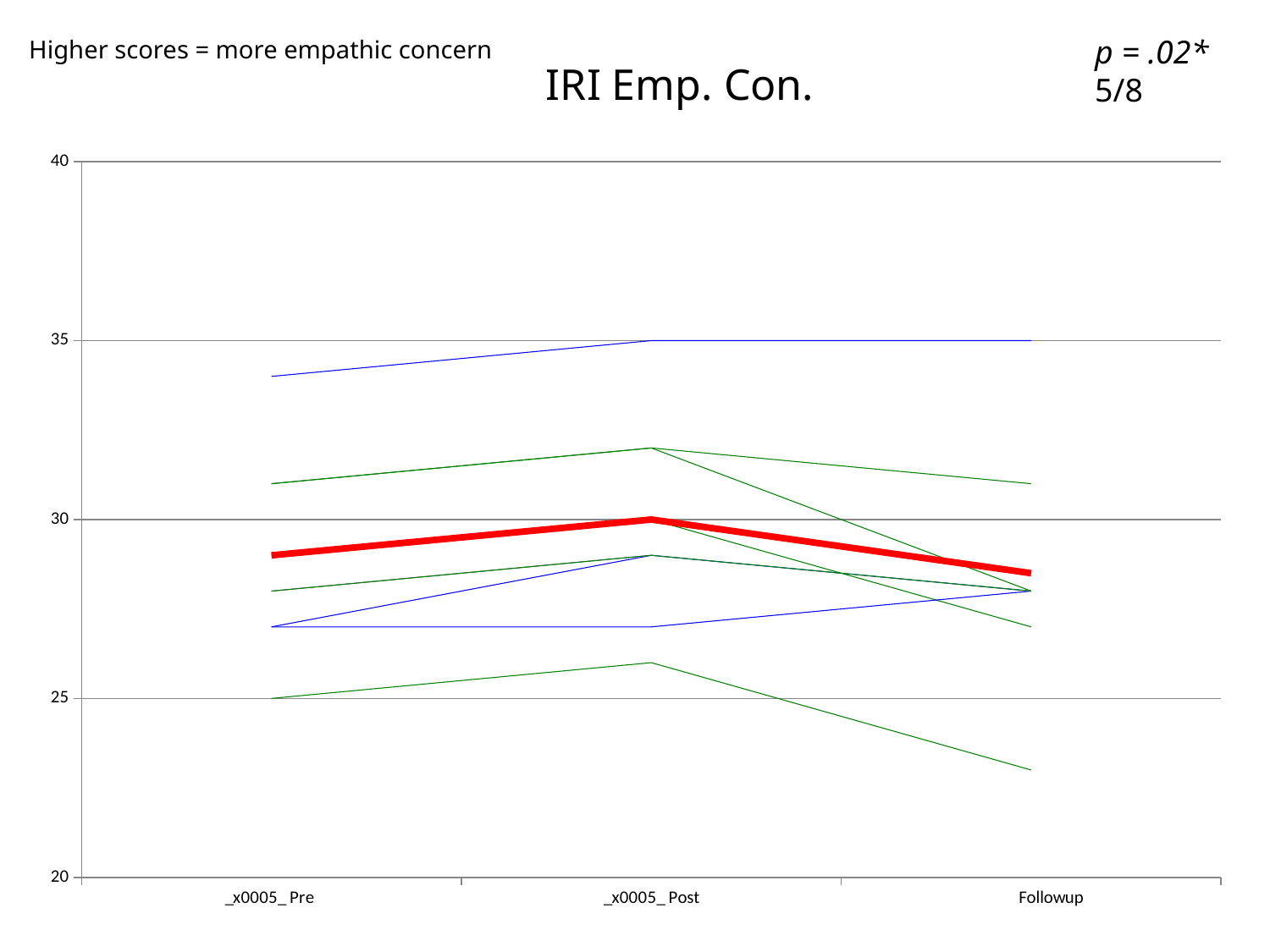
What is the title of the chart? IRI Emp. Con. Is the lowest plotted value at Followup greater or less than 25? less Is the value of the thick red line at _x0005_ Pre greater or less than 30? less At which category does the thick red line reach its highest value? _x0005_ Post What p value is printed on the slide? p = .02* Is the value of the topmost blue line at _x0005_ Pre greater or less than 30? greater What is the value of the topmost blue line at Followup? 35 Does the thick red line rise or fall from _x0005_ Post to Followup? fall How many categories are shown on the x axis? 3 What is the value of the thick red line at _x0005_ Post? 30 What kind of chart is shown on the slide? line chart